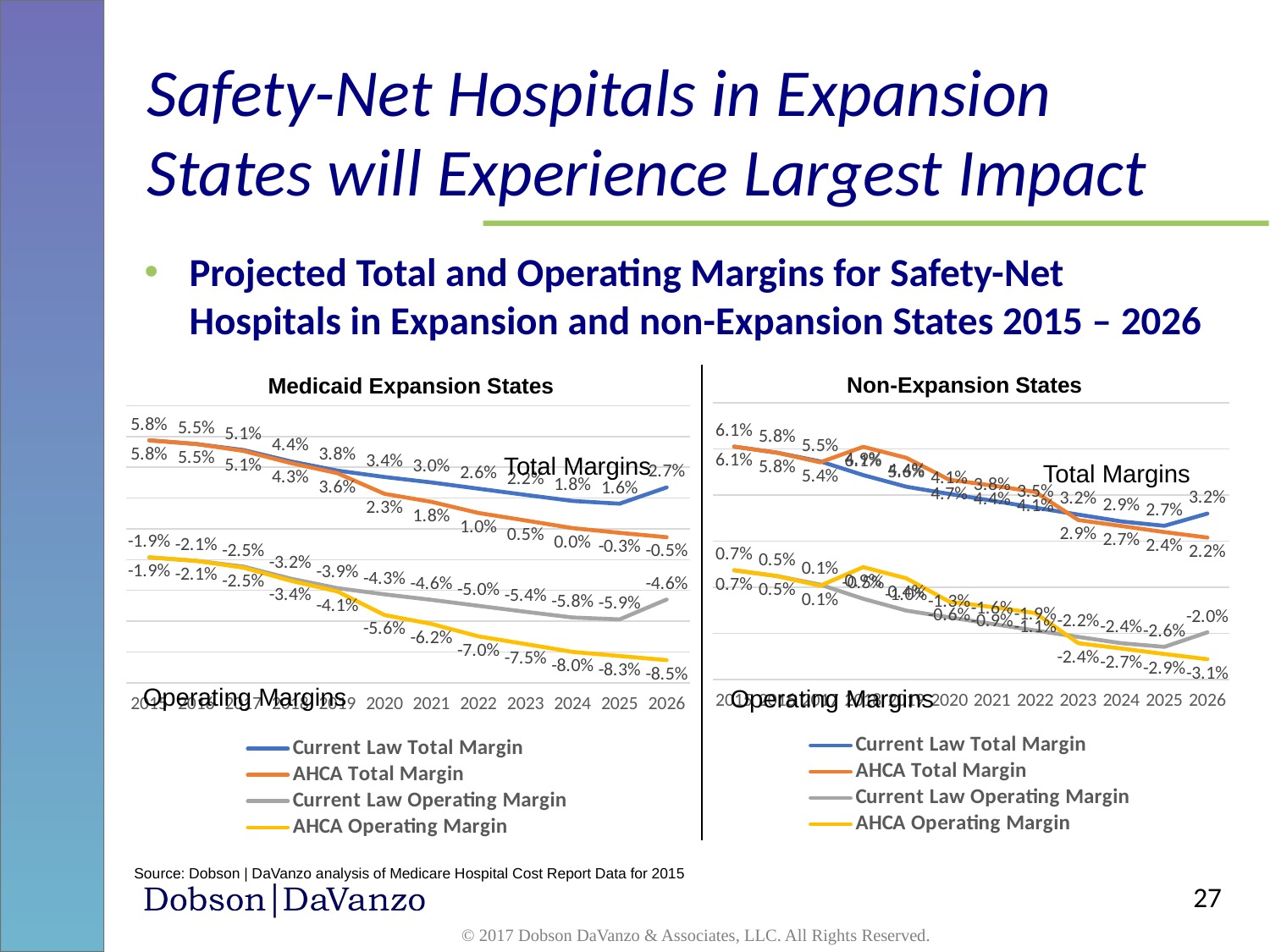
On the Medicaid Expansion States chart, in which year is the AHCA Operating Margin lowest? 2026 On the Medicaid Expansion States chart, what is the Current Law Total Margin in 2015? 5.8% How many series does the legend of the Non-Expansion States chart list? 4 What kind of chart is the Medicaid Expansion States chart? line chart On the Medicaid Expansion States chart, what is the difference between the Current Law Total Margin and the AHCA Total Margin in 2026? 3.2% On the Non-Expansion States chart, what is the Current Law Total Margin in 2015? 6.1% On the Medicaid Expansion States chart, what is the AHCA Operating Margin in 2026? -8.5% On the Non-Expansion States chart, what is the AHCA Operating Margin in 2026? -3.1% On the Medicaid Expansion States chart, what is the AHCA Total Margin in 2026? -0.5% On the Medicaid Expansion States chart, does the AHCA Operating Margin rise or fall from 2015 to 2026? fall On the Medicaid Expansion States chart, what is the Current Law Operating Margin in 2025? -5.9% On the Medicaid Expansion States chart, which is larger in 2022: the Current Law Total Margin or the AHCA Total Margin? Current Law Total Margin